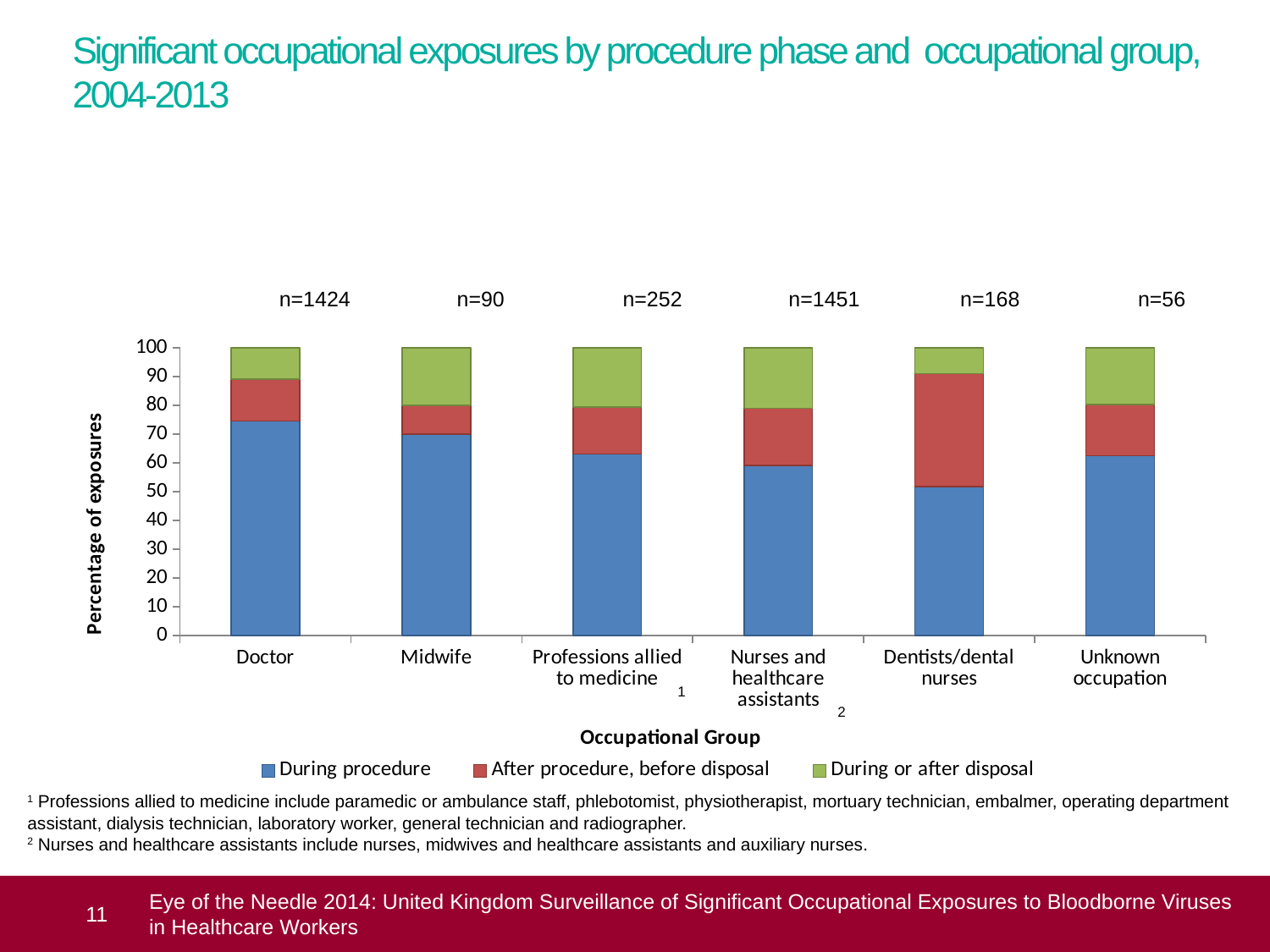
Which occupational group has the largest 'After procedure, before disposal' segment? Dentists/dental nurses Is the 'During procedure' value for Doctor greater or less than 70? greater What is the title of the y axis? Percentage of exposures What is the n value printed above the Doctor bar? n=1424 How many series does the legend list? 3 Which occupational group has the smallest 'During procedure' segment? Dentists/dental nurses What kind of chart is shown on the slide? Stacked bar chart Which occupational group has the largest 'During procedure' segment? Doctor How many occupational groups are shown on the x axis? 6 What is the n value printed above the Unknown occupation bar? n=56 Is the 'During procedure' value for Dentists/dental nurses greater or less than 60? less Which occupational group has the largest n value printed above its bar? Nurses and healthcare assistants